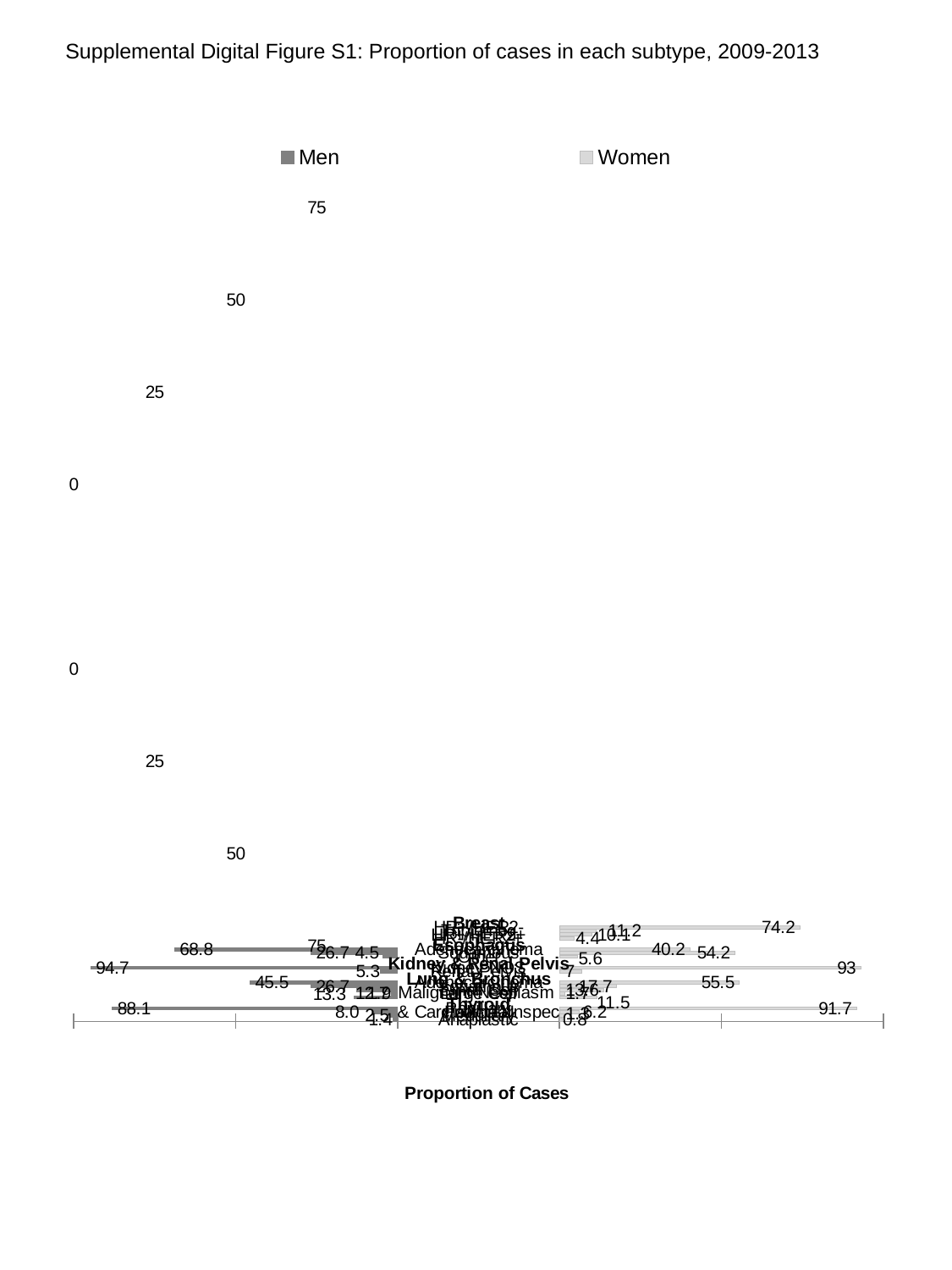
What is the largest value labelled on any Men bar? 94.7 What is the axis title shown below the bars? Proportion of Cases What is the largest value labelled on any Women bar? 93 What is the title of the chart? Supplemental Digital Figure S1: Proportion of cases in each subtype, 2009-2013 How many series does the chart's legend list? 2 What kind of chart is shown on the slide? Bar chart What are the two series named in the legend? Men and Women What is the difference between the largest Men value (94.7) and the largest Women value (93)? 1.7 Which is larger, the largest Men value (94.7) or the largest Women value (93)? Men (94.7)